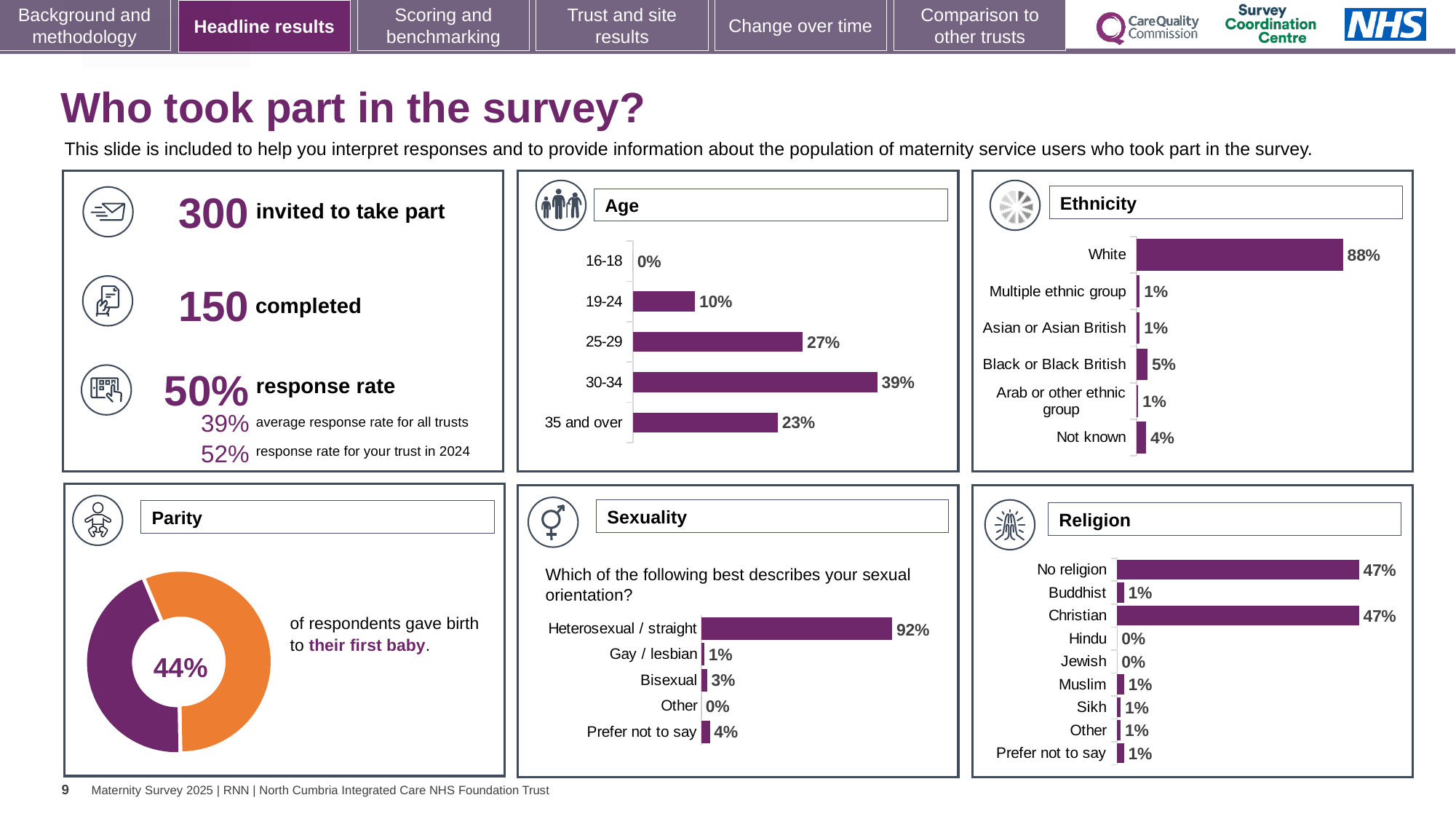
In the Religion chart, what is the difference between the percentages for Christian and Muslim? 46% In the Ethnicity chart, what percentage of respondents were White? 88% In the Ethnicity chart, which is larger, Black or Black British or Not known? Black or Black British In the Ethnicity chart, how many ethnic categories are listed? 6 In the Age chart, what percentage of respondents were aged 30-34? 39% In the Age chart, which age group has the lowest percentage? 16-18 In the Sexuality chart, what percentage of respondents answered Heterosexual / straight? 92% What kind of chart is used in the Parity panel? Donut chart In the Age chart, how many age groups are shown? 5 In the Parity chart, what percentage of respondents gave birth to their first baby? 44% In the Age chart, what is the difference between the percentages for 30-34 and 25-29? 12% In the Age chart, which age group has the highest percentage? 30-34